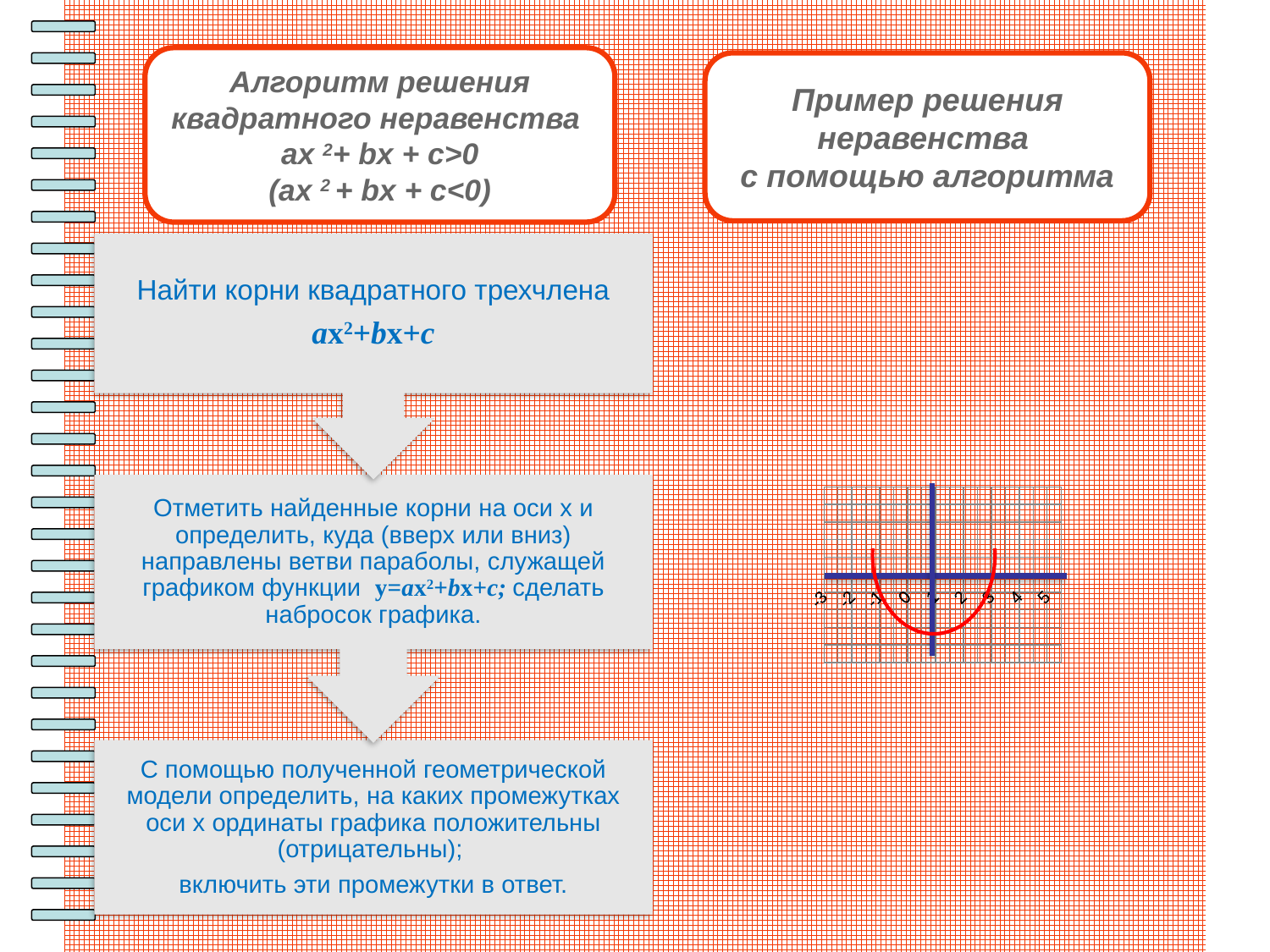
On the coordinate sketch on the right, what colour is the parabola drawn in? red On the coordinate sketch on the right, is the x-coordinate of the parabola's vertex greater or less than 0? greater On the coordinate sketch on the right, what colour are the coordinate axes? blue On the coordinate sketch on the right, in which direction do the branches of the parabola open, upward or downward? upward On the coordinate sketch on the right, what is the largest tick label shown on the x axis? 5 On the coordinate sketch on the right, is the vertex of the parabola above or below the x axis? below On the coordinate sketch on the right, how many tick labels are printed along the x axis? 9 On the coordinate sketch on the right, what is the smallest tick label shown on the x axis? -3